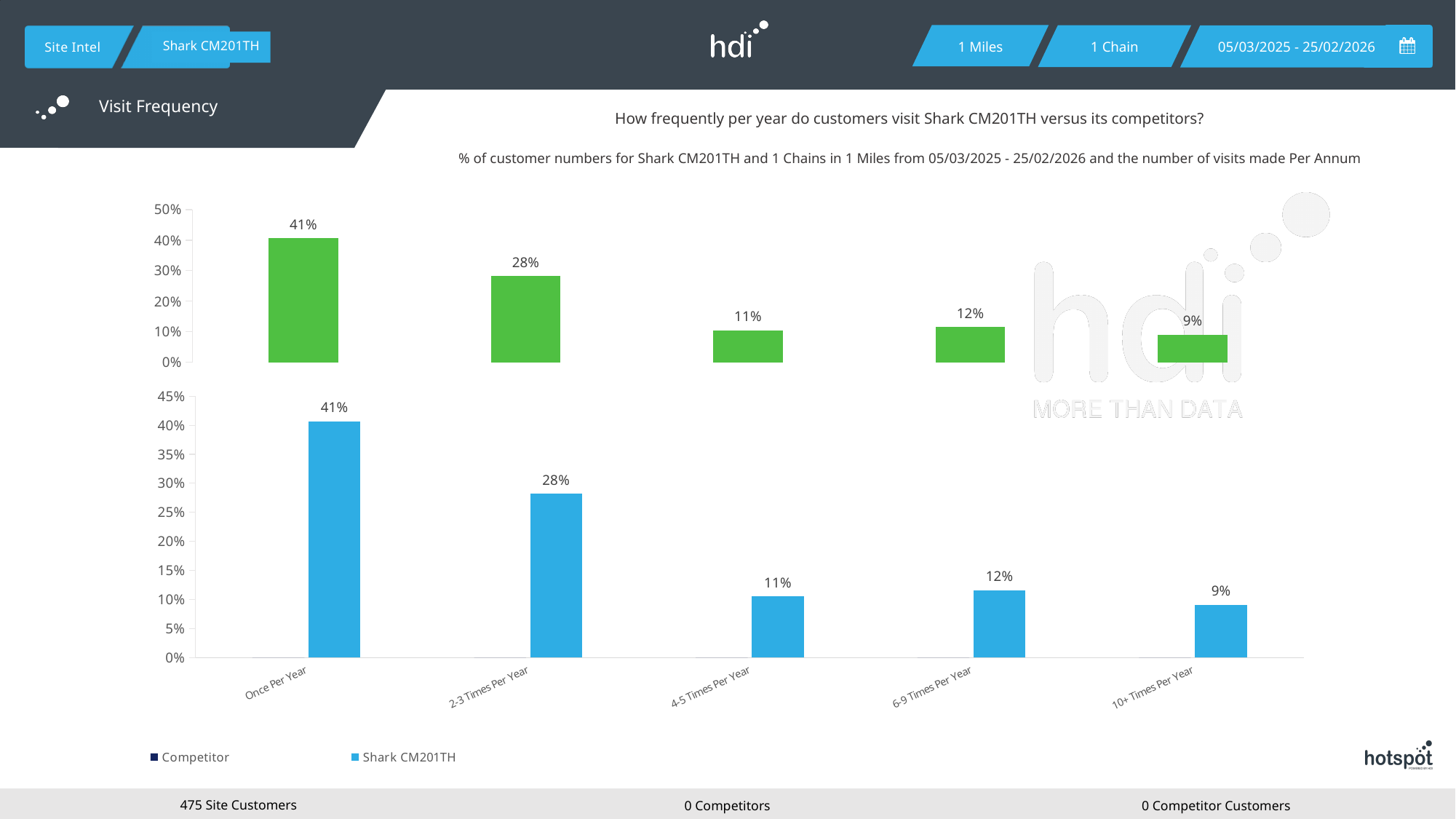
In the bottom chart, which is larger, the value for 4-5 Times Per Year or 6-9 Times Per Year? 6-9 Times Per Year In the bottom chart, what is the difference between the values for Once Per Year and 2-3 Times Per Year? 13% What kind of chart is the bottom chart? bar chart How many series does the legend at the bottom of the slide list? 2 How many categories are shown on the x axis of the bottom chart? 5 In the bottom chart, which category has the lowest value? 10+ Times Per Year In the bottom chart, which category has the highest value? Once Per Year In the bottom chart, what is the value for 2-3 Times Per Year? 28% In the bottom chart, is the value for 2-3 Times Per Year greater or less than 25%? greater In the bottom chart, what is the value for Once Per Year? 41% In the bottom chart, what is the value for 10+ Times Per Year? 9% In the top chart, what is the highest value shown on a data label? 41%